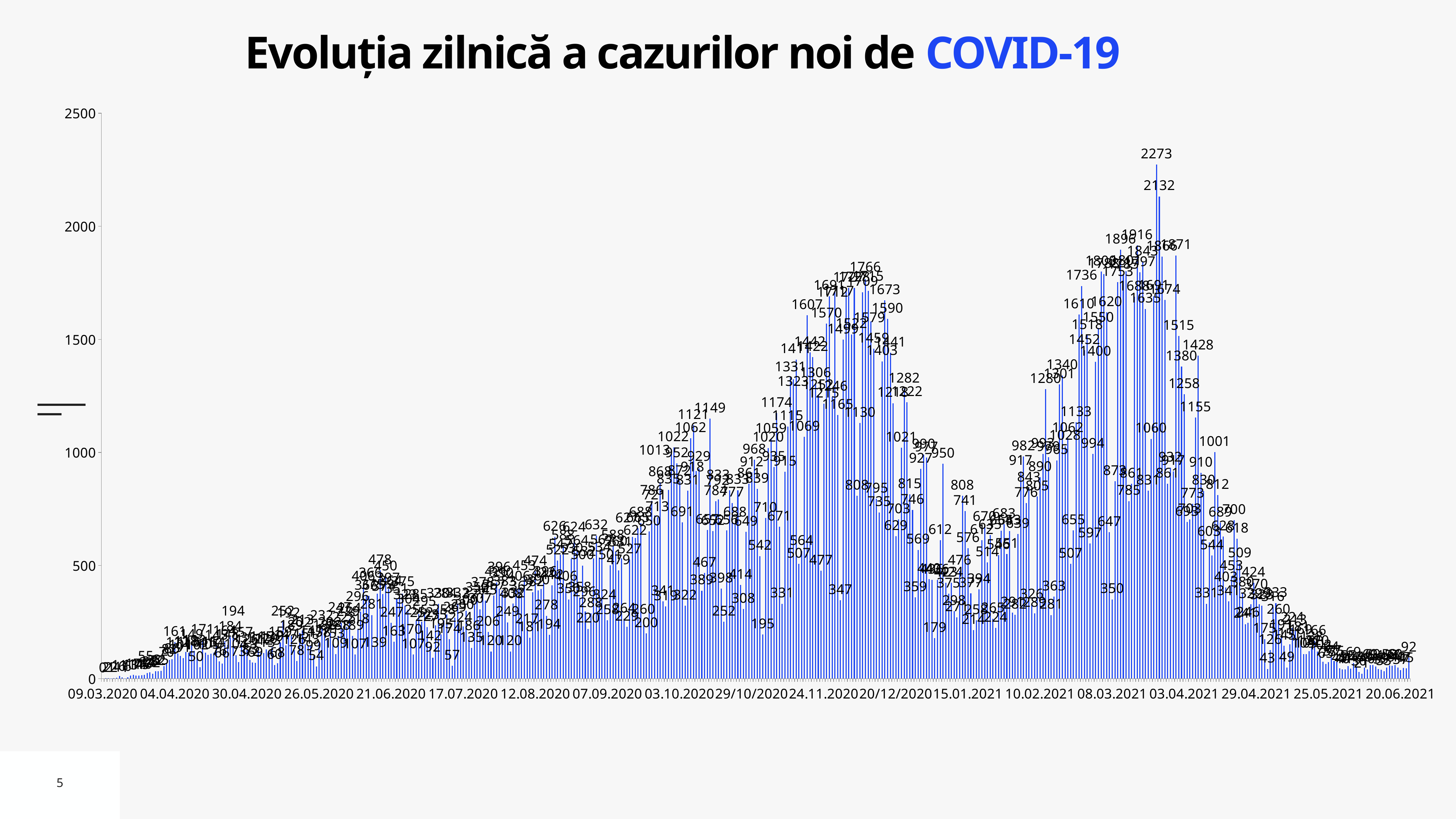
What is the highest value labelled in the wave around 24.11.2020? 1766 Which wave peaks higher: the one around 24.11.2020 or the one around 03.04.2021? 03.04.2021 What is the highest daily value labelled on the chart? 2273 What is the topmost tick value on the vertical axis? 2500 What is the title of the chart? Evoluția zilnică a cazurilor noi de COVID-19 What kind of chart is shown on the slide? bar chart What is the first date shown on the horizontal axis? 09.03.2020 Do the values rise or fall between 03.04.2021 and 20.06.2021? fall What is the second-highest value labelled, just below the 2273 peak? 2132 What is the difference between the two highest labelled values, 2273 and 2132? 141 Are the values in the first days after 09.03.2020 greater or less than 500? less Is the peak value around 03.04.2021 greater or less than 2000? greater